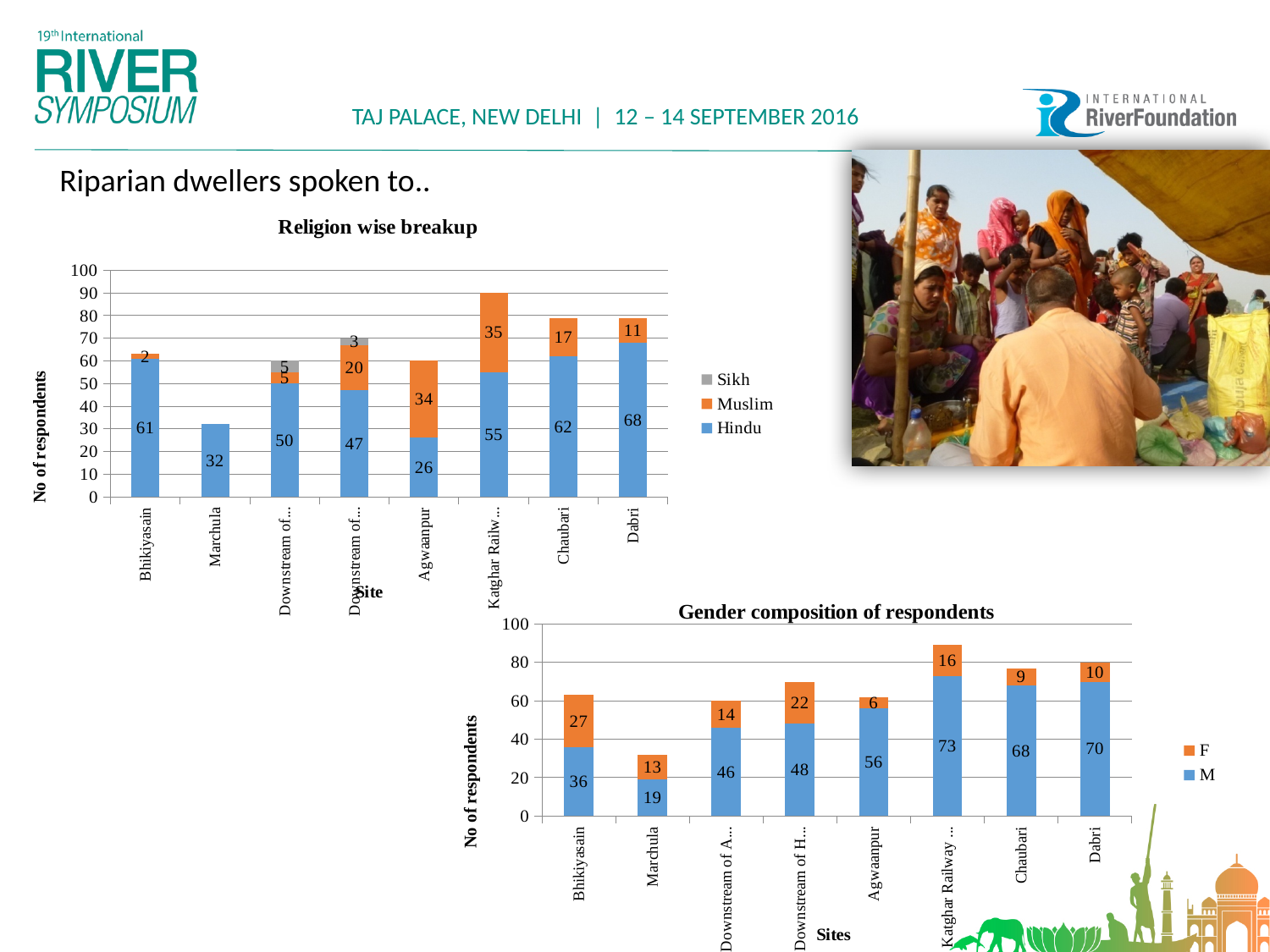
In the 'Religion wise breakup' chart, how many Hindu respondents are there at Dabri? 68 In the 'Religion wise breakup' chart, what is the total number of respondents at Chaubari? 79 In the 'Gender composition of respondents' chart, how many female respondents are there at Bhikiyasain? 27 In the 'Religion wise breakup' chart, which site has the lowest number of Hindu respondents? Agwaanpur In the 'Religion wise breakup' chart, how many series does the legend list? 3 In the 'Gender composition of respondents' chart, how many male respondents are there at Agwaanpur? 56 In the 'Religion wise breakup' chart, what is the difference between the Hindu respondents at Dabri and at Marchula? 36 In the 'Gender composition of respondents' chart, are there more male respondents at Chaubari or at Dabri? Dabri In the 'Gender composition of respondents' chart, which site has the highest number of female respondents? Bhikiyasain In the 'Religion wise breakup' chart, how many Muslim respondents are there at Agwaanpur? 34 What type of chart is the 'Gender composition of respondents' chart? Stacked bar chart In the 'Gender composition of respondents' chart, what is the total number of respondents at Marchula? 32